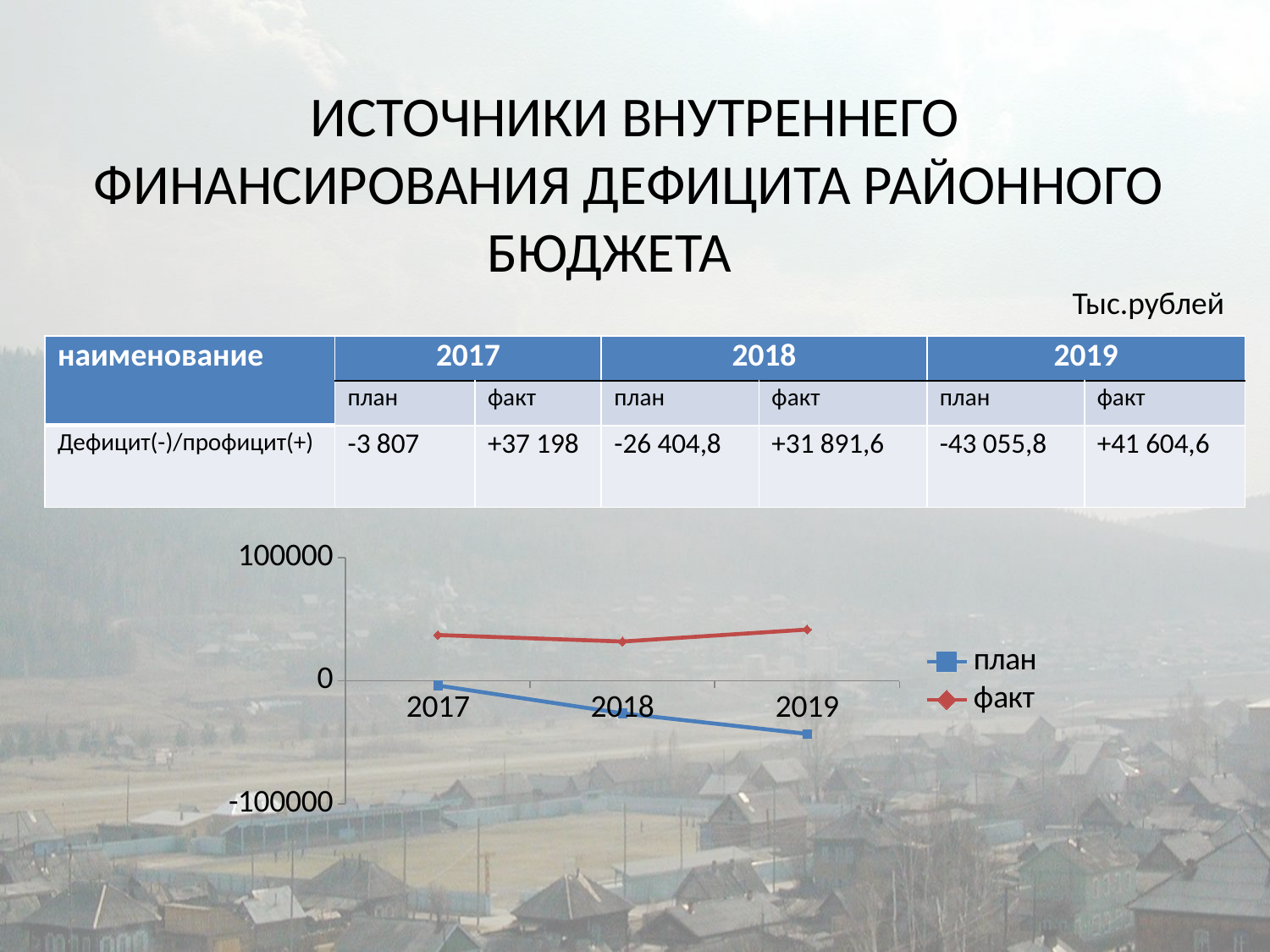
Is the value for факт in 2018 greater or less than 0? greater According to the table, what is the факт value for 2017? +37 198 What kind of chart is shown on the slide? line chart In which year is the план value the lowest? 2019 Does the план series rise or fall from 2017 to 2019? fall How many series does the chart legend list? 2 Which series is drawn in red on the chart? факт Which is larger in 2018, the план value or the факт value? факт Is the value for план in 2019 greater or less than 0? less In which year is the факт value the highest? 2019 According to the table, what is the план value for 2019? -43 055,8 How many years are plotted along the x axis of the chart? 3